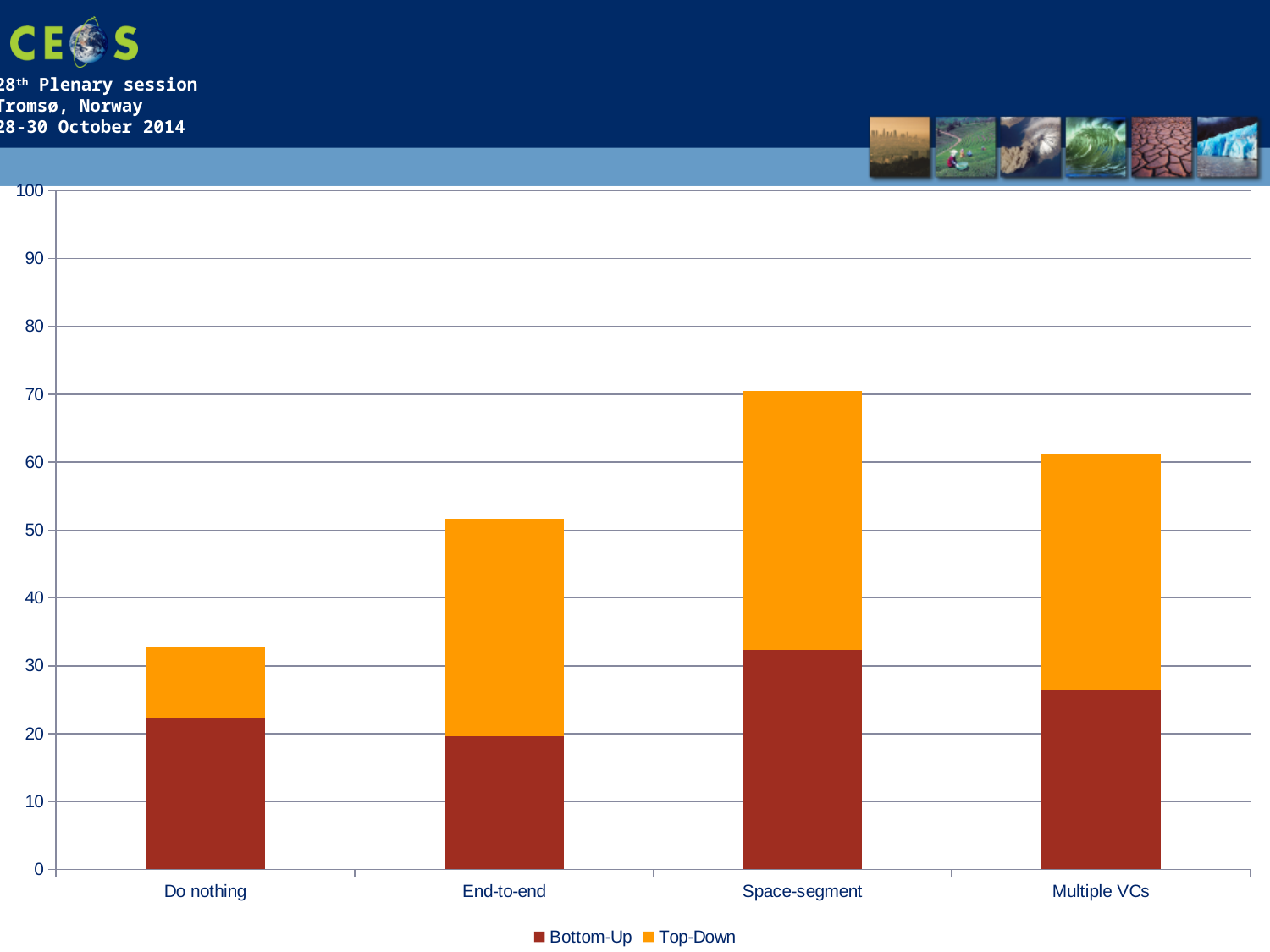
How many series does the legend list? 2 Is the total stacked value for Do nothing greater or less than 30? greater How many categories are shown along the x axis? 4 Which has the larger total stacked bar, End-to-end or Multiple VCs? Multiple VCs Which category has the shortest stacked bar overall? Do nothing Which colour represents the Top-Down series in the legend? orange Is the total stacked value for Multiple VCs greater or less than 70? less Which category has the tallest stacked bar overall? Space-segment What kind of chart is shown on the slide? stacked bar chart Is the Bottom-Up value for Multiple VCs greater or less than 30? less Which category has the largest Bottom-Up segment? Space-segment